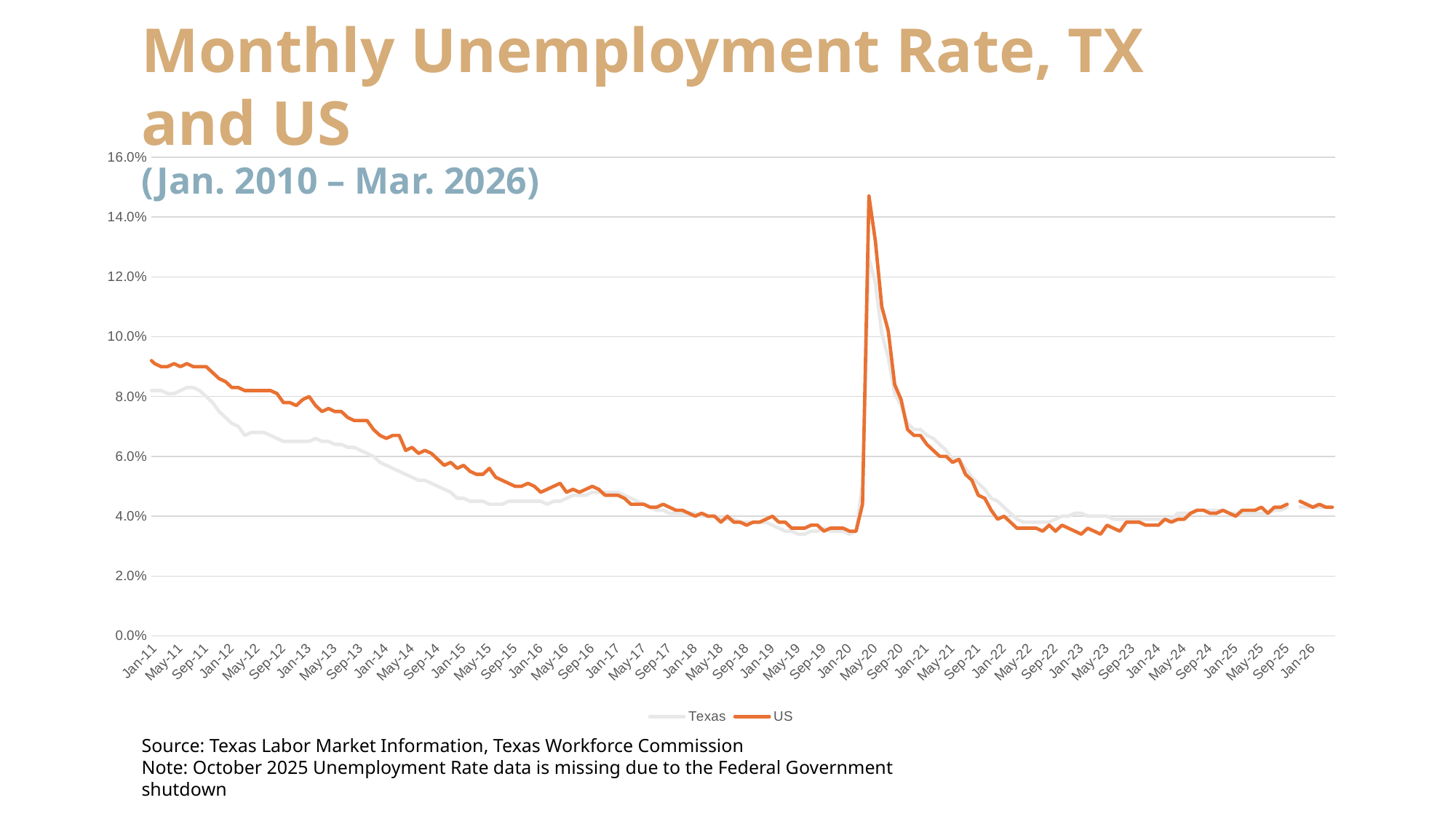
How many series does the legend list? 2 Is the Texas unemployment rate at Jan-19 greater or less than 4.0%? less Is the Texas unemployment rate at Jan-12 greater or less than 6.0%? greater What are the two series shown in the legend? Texas and US Does the US unemployment rate generally rise or fall from Jan-11 to Jan-20? fall What is the title of the chart? Monthly Unemployment Rate, TX and US (Jan. 2010 – Mar. 2026) Is the peak of the US line around May-20 greater or less than 14.0%? greater What kind of chart is shown on the slide? line chart Which series reaches the higher peak around May-20, Texas or US? US At Jan-11, which series has the higher unemployment rate, Texas or US? US